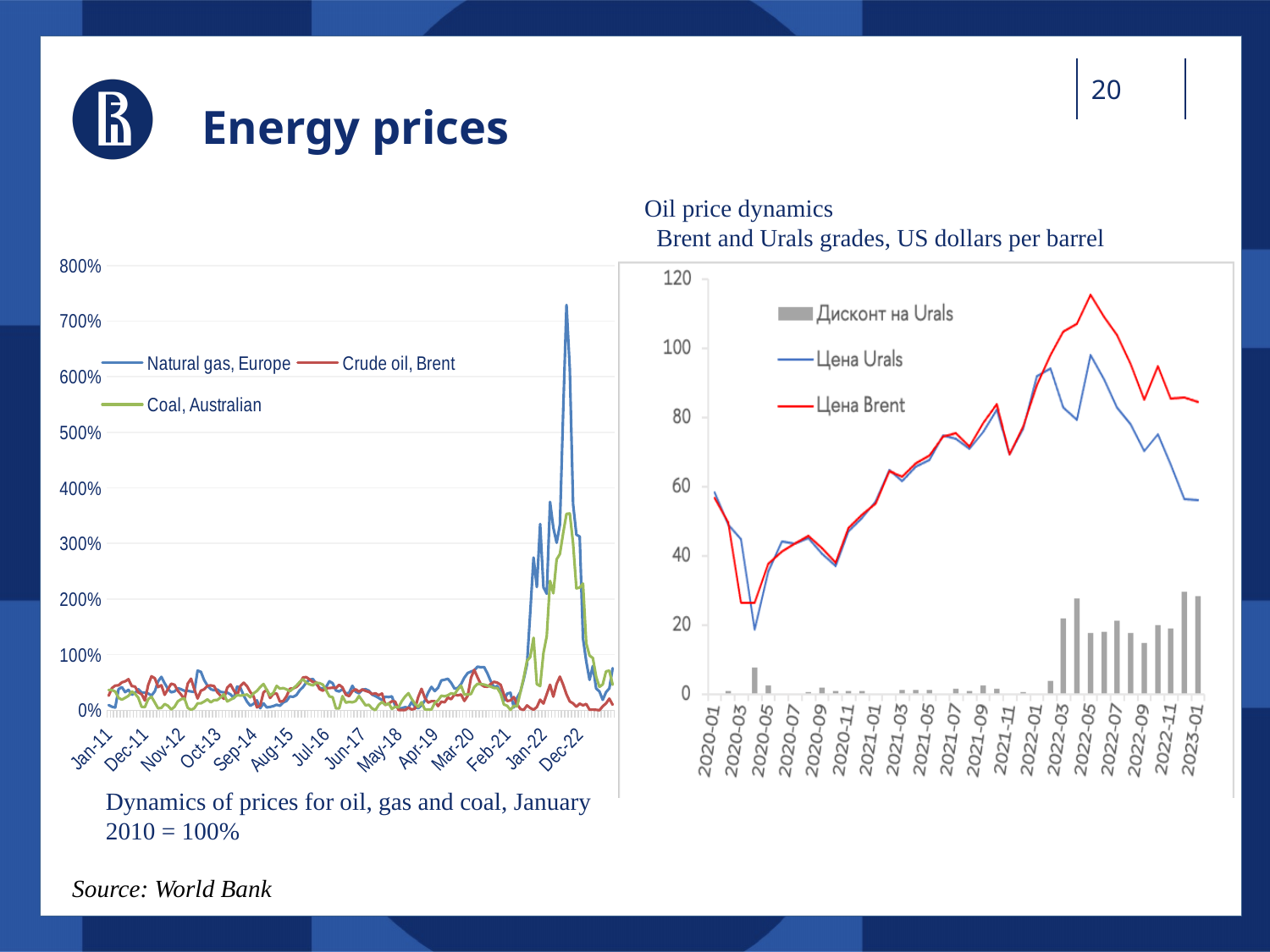
In the right chart (Oil price dynamics), is the value of Цена Urals at 2023-01 greater or less than 60? less In the right chart (Oil price dynamics), which series is shown as grey bars? Дисконт на Urals In the right chart (Oil price dynamics), is the peak value of Цена Brent greater or less than 100? greater In the left chart (Dynamics of prices for oil, gas and coal), is the peak value of Natural gas, Europe greater or less than 700%? greater How many series does the legend of the left chart (Dynamics of prices for oil, gas and coal) list? 3 In the right chart (Oil price dynamics), does Цена Urals rise or fall between 2022-05 and 2023-01? Fall How many series does the legend of the right chart (Oil price dynamics) list? 3 In the right chart (Oil price dynamics), which is higher in 2022-05: Цена Brent or Цена Urals? Цена Brent What kind of chart is the left chart (Dynamics of prices for oil, gas and coal)? Line chart In the left chart (Dynamics of prices for oil, gas and coal), which series reaches the highest value? Natural gas, Europe